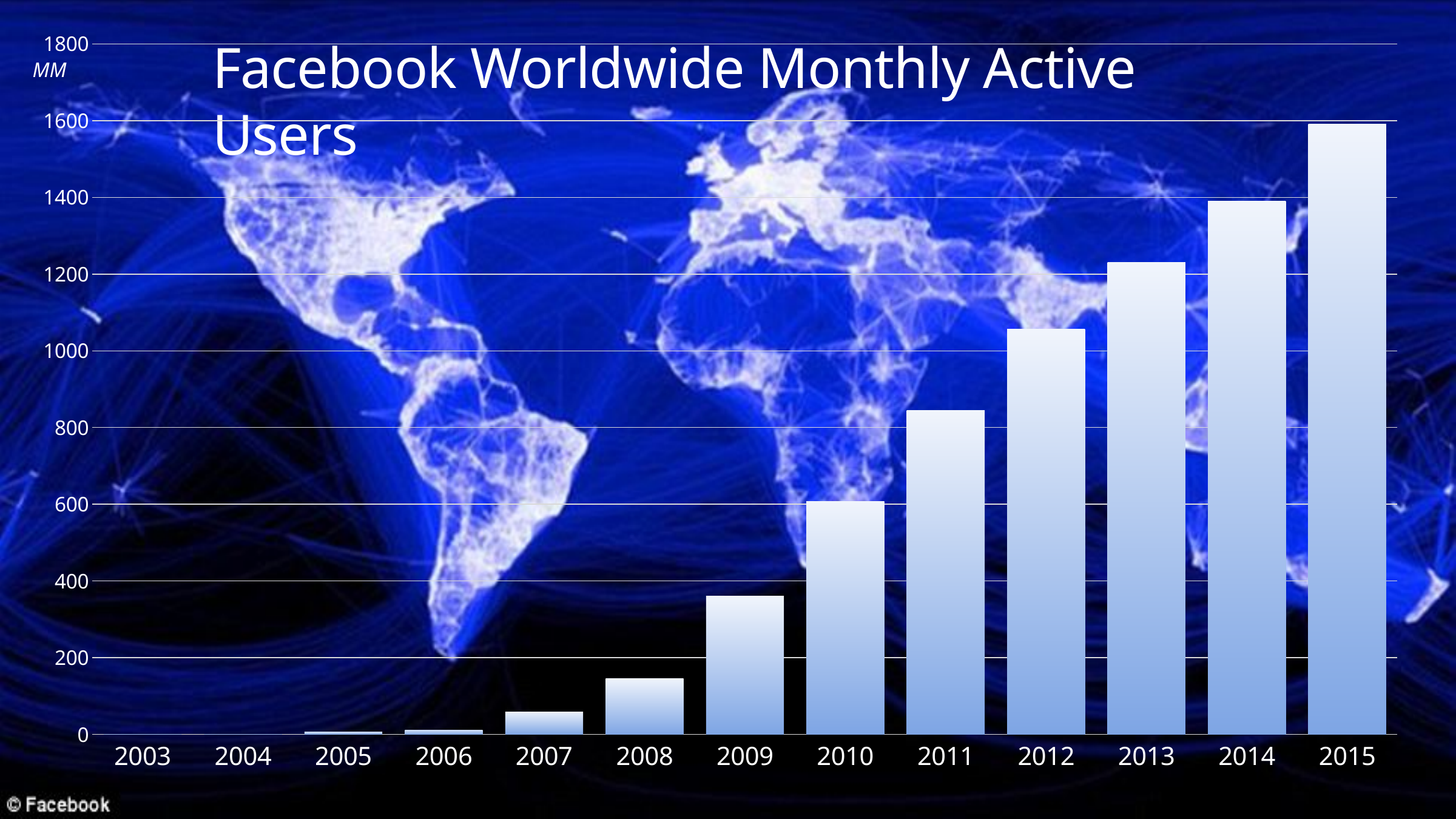
Which year has the highest number of monthly active users? 2015 What unit label is shown at the top of the y axis? MM Do the values rise or fall from 2003 to 2015? rise What is the title of the chart? Facebook Worldwide Monthly Active Users What kind of chart is shown on the slide? bar chart Is the value for 2014 greater or less than 1200? greater Which is larger, the value for 2012 or the value for 2011? 2012 Is the value for 2013 greater or less than 1400? less Is the value for 2015 greater or less than 1400? greater How many years are shown on the x axis of the chart? 13